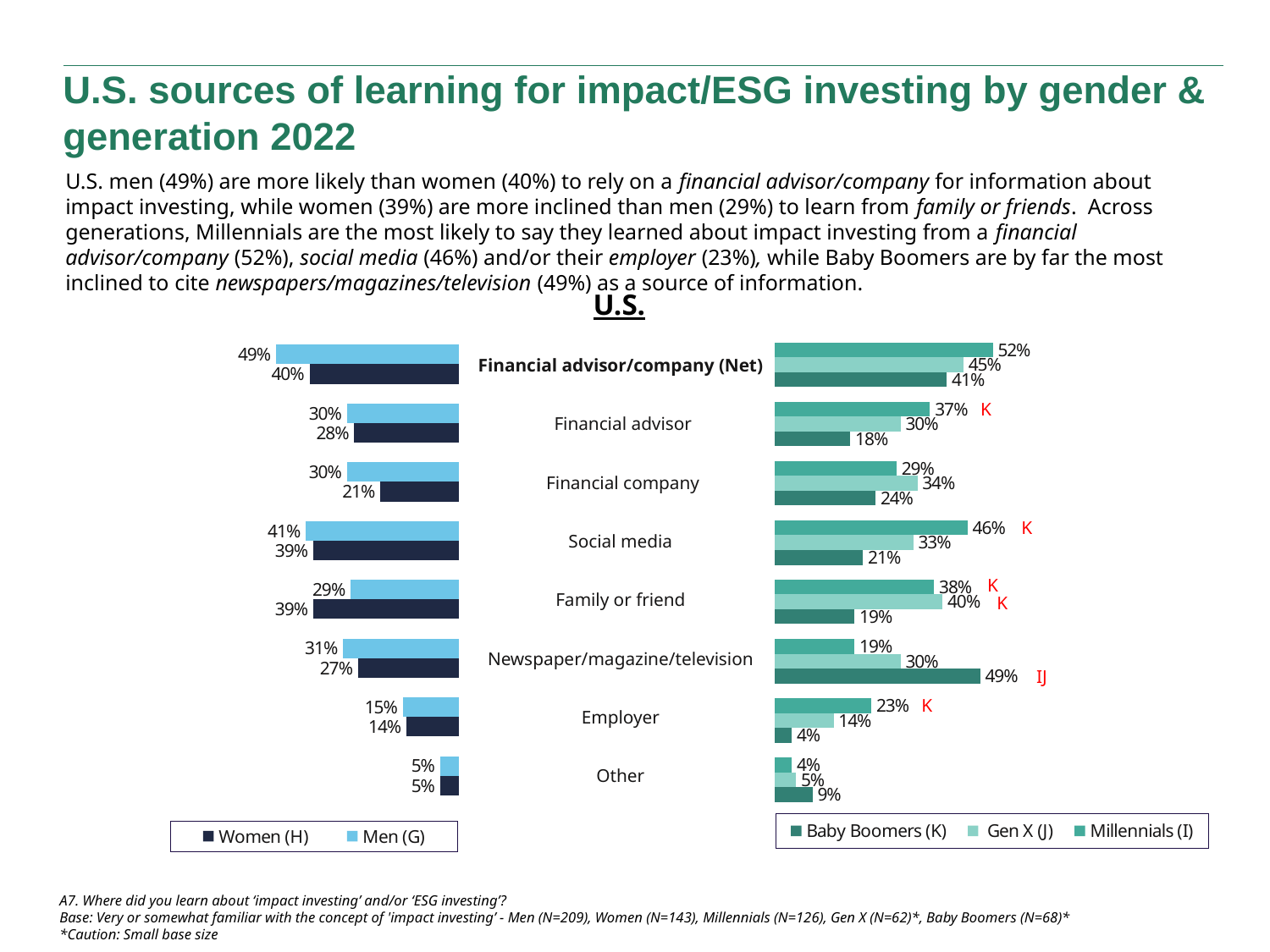
In the right chart (by generation), what is the difference between Millennials and Baby Boomers for social media? 25 percentage points How many categories are shown in the right chart (by generation)? 8 In the left chart (by gender), how many series does the legend list? 2 In the right chart (by generation), which generation has the highest value for employer? Millennials (I) In the right chart (by generation), what percentage of Baby Boomers cite newspaper/magazine/television? 49% In the right chart (by generation), is the value for Gen X or Baby Boomers larger for financial advisor? Gen X In the left chart (by gender), what percentage of women cite family or friend as a source of learning? 39% In the right chart (by generation), what percentage of Millennials cite social media? 46% In the left chart (by gender), what is the difference between men and women for financial company? 9 percentage points In the left chart (by gender), what percentage of men cite a financial advisor/company (Net) as a source of learning? 49% In the left chart (by gender), which category has the lowest value for women? Other What type of chart is used on the left side of the slide? Bar chart